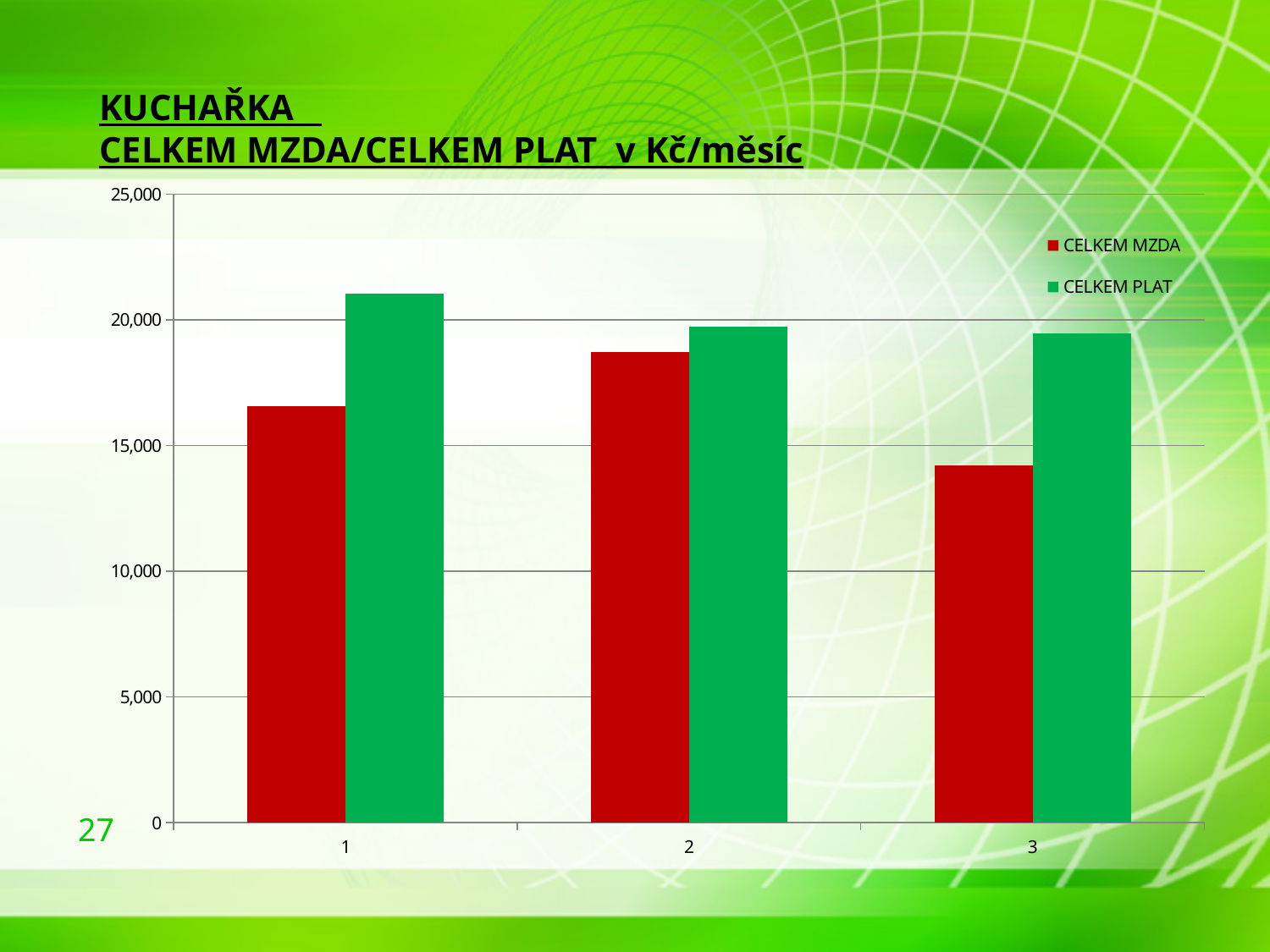
For category 1, which is larger: CELKEM MZDA or CELKEM PLAT? CELKEM PLAT How many series does the legend list? 2 Is the CELKEM MZDA value for category 2 greater or less than 20,000? less How many categories are shown on the x axis? 3 Is the CELKEM MZDA value for category 1 greater or less than 15,000? greater What kind of chart is shown on the slide? bar chart Which series is shown in red? CELKEM MZDA Is the CELKEM MZDA value for category 3 greater or less than 15,000? less For which category is CELKEM MZDA lowest? 3 For which category is CELKEM MZDA highest? 2